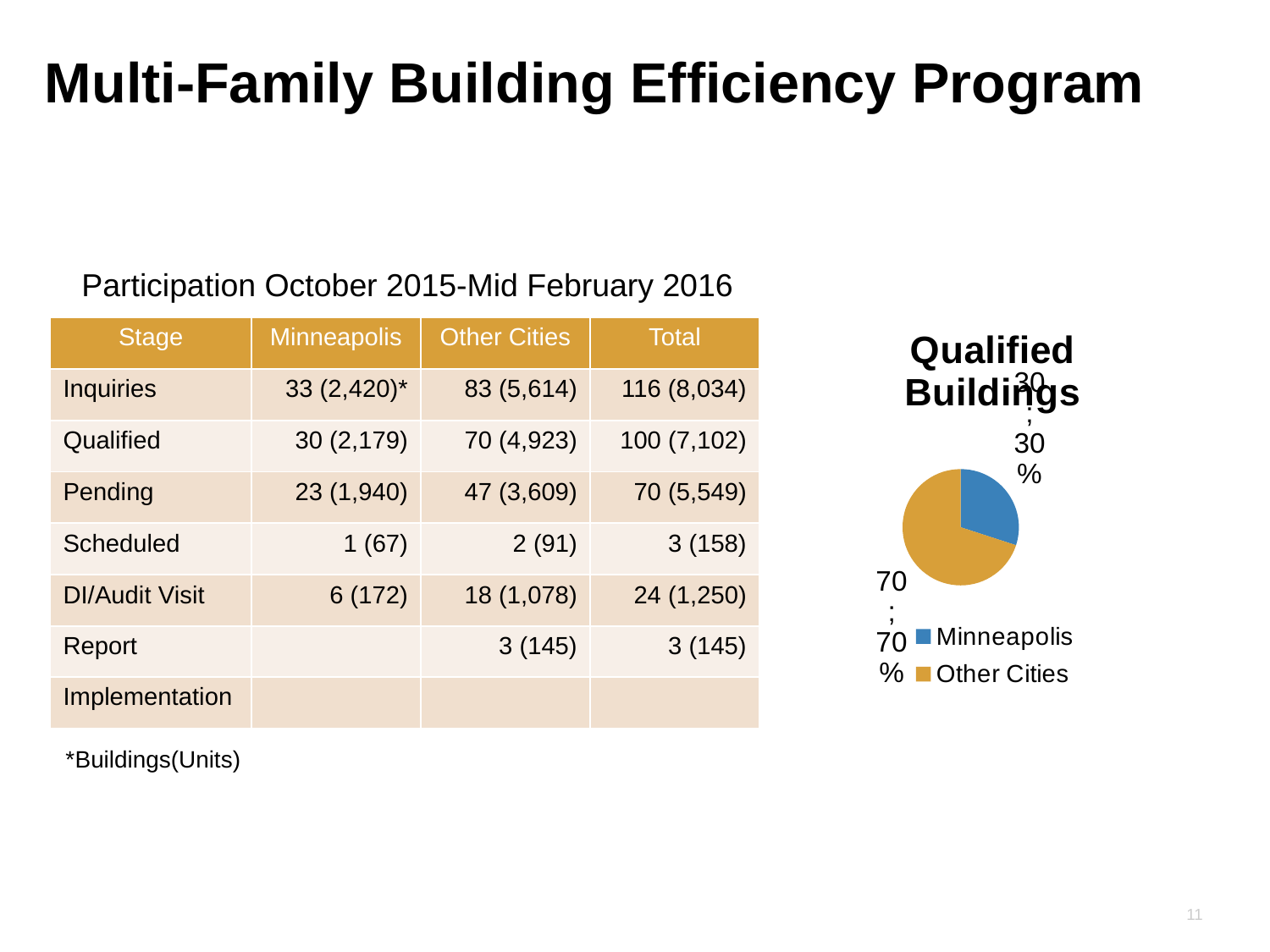
What is the value for Other Cities in the pie chart? 70 What share of the pie does Other Cities represent? 70% What share of the pie does Minneapolis represent? 30% How many slices does the pie chart have? 2 What kind of chart is shown on the slide? pie chart Which colour represents Minneapolis in the pie chart? blue Which slice of the pie chart is the smallest? Minneapolis What is the value for Minneapolis in the pie chart? 30 Which slice of the pie chart is the largest? Other Cities What is the title of the pie chart? Qualified Buildings How many series does the pie chart's legend list? 2 What is the difference between the Other Cities value and the Minneapolis value in the pie chart? 40